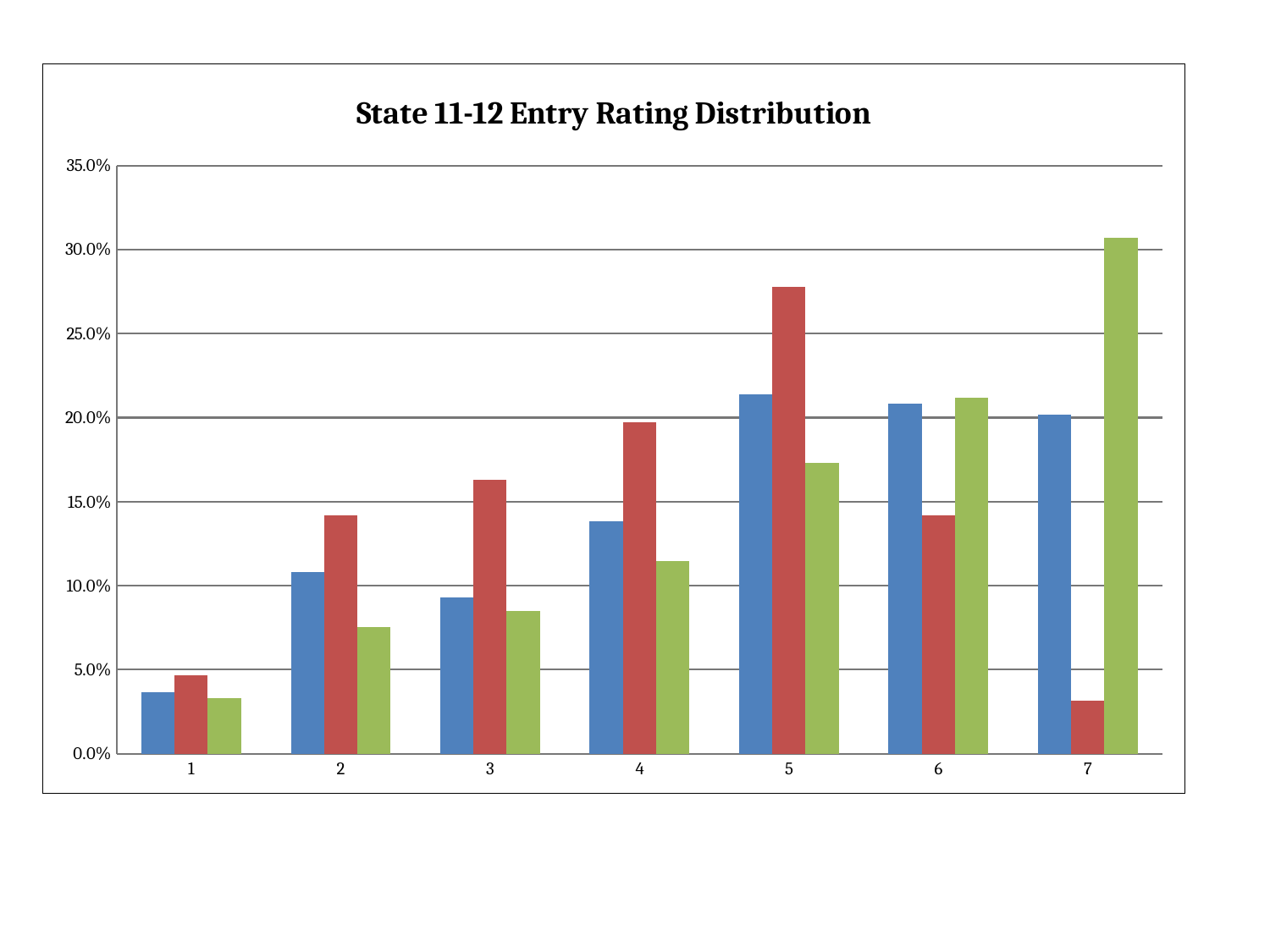
How many bars are plotted for each category? 3 Is the blue bar for category 5 greater or less than 20.0%? greater Is the green bar for category 7 greater or less than 25.0%? greater Which category has the tallest green bar? 7 Which category has the shortest blue bar? 1 Is the red bar for category 7 greater or less than 5.0%? less For category 7, which is larger, the blue bar or the red bar? the blue bar How many categories are shown on the x axis? 7 What is the title of the chart? State 11-12 Entry Rating Distribution What kind of chart is shown on the slide? bar chart Which category has the tallest red bar? 5